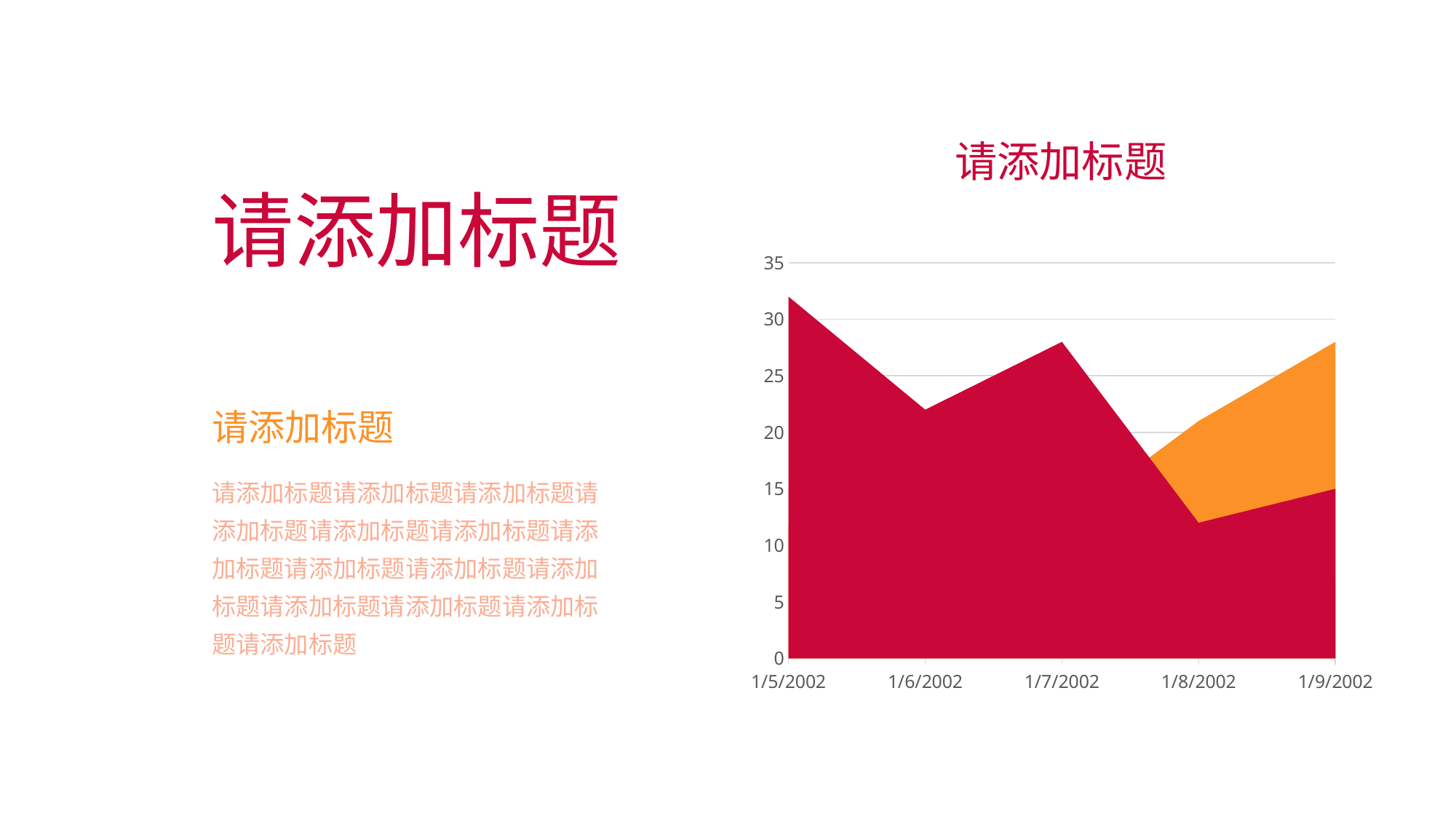
Does the red series rise or fall from 1/7/2002 to 1/8/2002? fall How many dates are shown on the x axis of the chart? 5 On which date does the red series reach its highest value? 1/5/2002 On which date does the red series reach its lowest value? 1/8/2002 Is the value of the red series at 1/5/2002 greater or less than 25? greater Which is larger for the red series: the value at 1/5/2002 or the value at 1/7/2002? 1/5/2002 What kind of chart is shown on the slide? area chart What two colours are used for the areas in the chart? red and orange Is the value of the red series at 1/6/2002 greater or less than 25? less What is the title of the chart? 请添加标题 Is the value of the orange series at 1/9/2002 greater or less than 25? greater